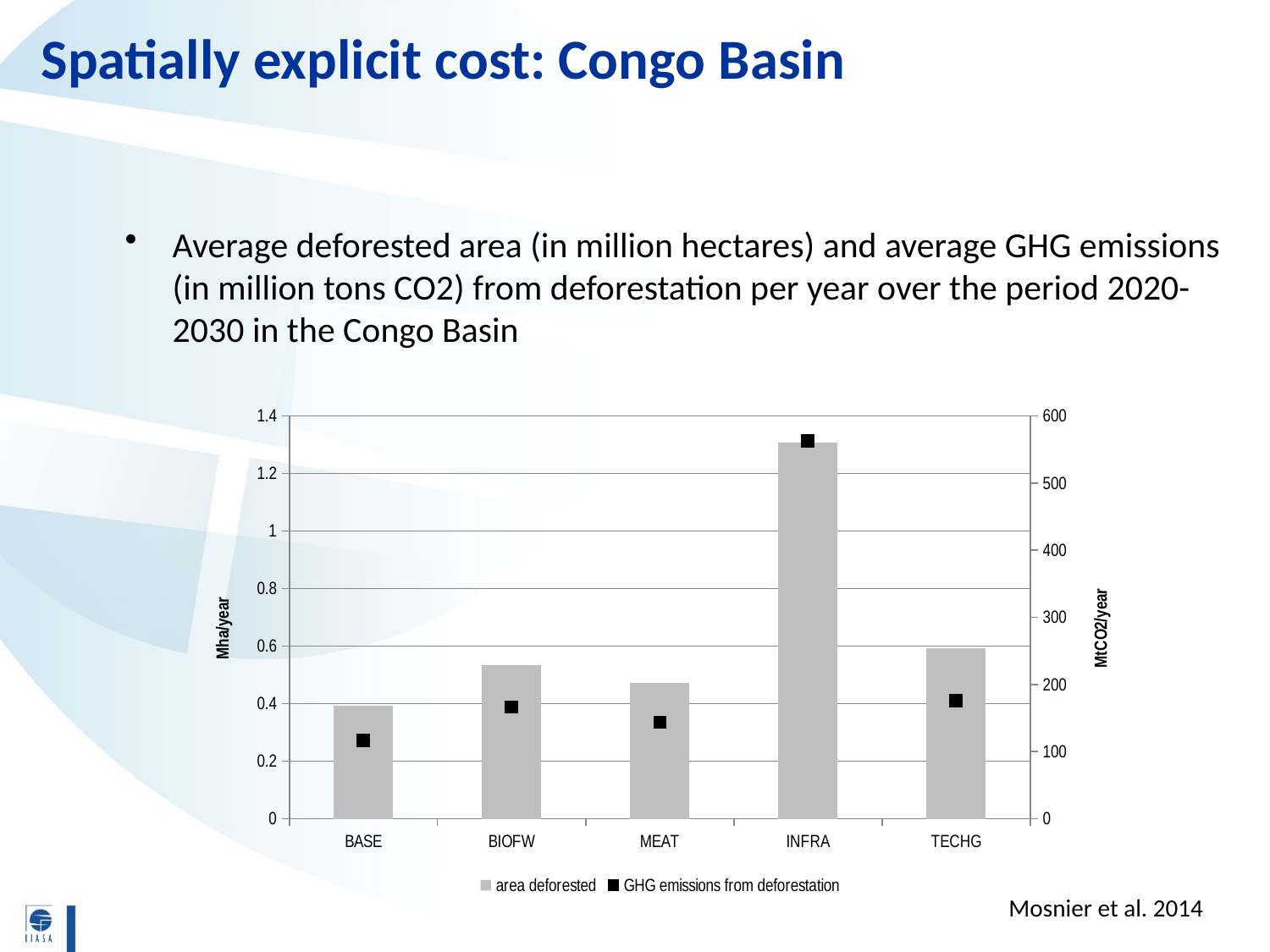
How many series does the chart's legend list? 2 What is the label of the right-hand vertical axis of the chart? MtCO2/year Which scenario has the lowest GHG emissions from deforestation? BASE Are the GHG emissions from deforestation for INFRA greater or less than 500 MtCO2/year? greater Is the area deforested for INFRA greater or less than 1.2 Mha/year? greater Are the GHG emissions from deforestation for MEAT greater or less than 200 MtCO2/year? less Which scenario has a larger area deforested, BIOFW or MEAT? BIOFW Which scenario has the smallest area deforested? BASE Which scenario has the highest GHG emissions from deforestation? INFRA How many scenarios (categories) are shown on the x axis of the chart? 5 Which scenario has the largest area deforested? INFRA What kind of chart is shown on the slide? combination bar and line chart (bars with square point markers)